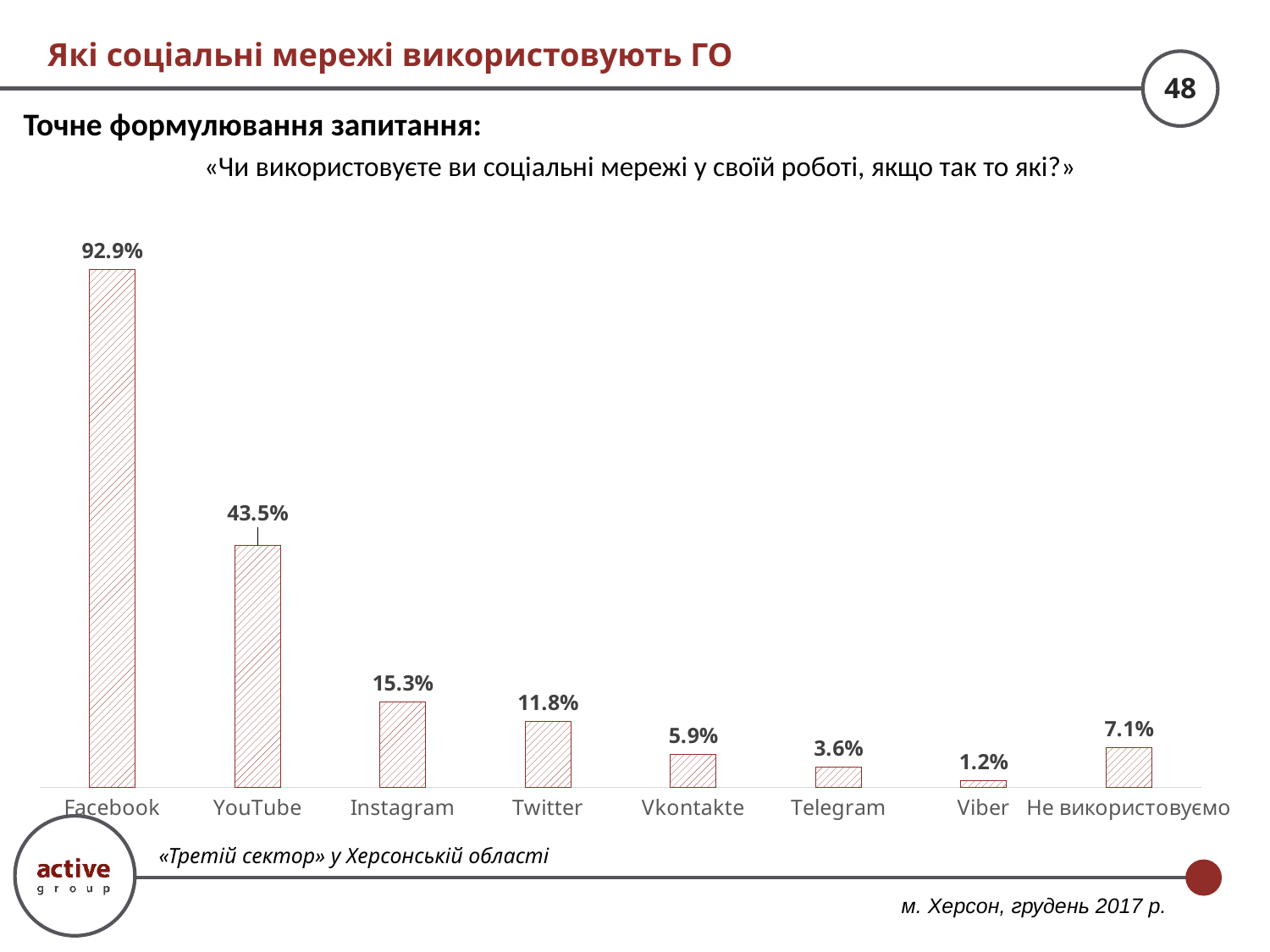
What is the title of the slide? Які соціальні мережі використовують ГО What is the value for Не використовуємо? 7.1% Which category has the highest value? Facebook Which category has the lowest value? Viber Which is larger, the value for Vkontakte or the value for Не використовуємо? Не використовуємо What is the value for Facebook? 92.9% What is the difference between the values for Facebook and YouTube? 49.4% What is the difference between the values for Instagram and Twitter? 3.5% What is the value for Telegram? 3.6% What is the value for YouTube? 43.5% How many categories are shown on the x axis? 8 What kind of chart is shown on the slide? bar chart